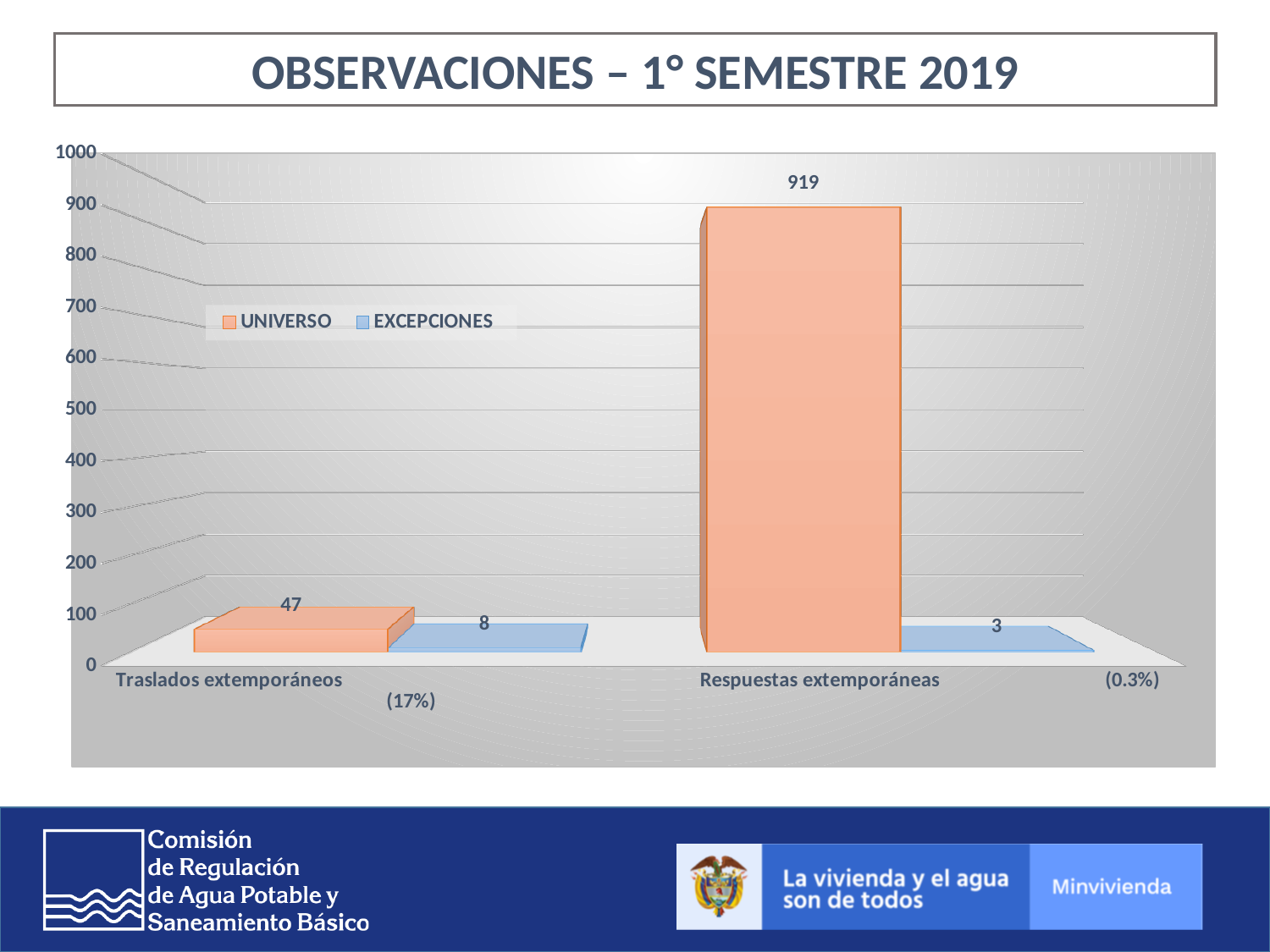
Which is larger: the EXCEPCIONES value for Traslados extemporáneos or for Respuestas extemporáneas? Traslados extemporáneos What kind of chart is shown on the slide? Bar chart What is the difference between the UNIVERSO values for Respuestas extemporáneas and Traslados extemporáneos? 872 What is the EXCEPCIONES value for Respuestas extemporáneas? 3 What is the difference between the UNIVERSO and EXCEPCIONES values for Traslados extemporáneos? 39 Which category has the highest UNIVERSO value? Respuestas extemporáneas What is the UNIVERSO value for Traslados extemporáneos? 47 What is the UNIVERSO value for Respuestas extemporáneas? 919 Which category has the lowest EXCEPCIONES value? Respuestas extemporáneas What is the EXCEPCIONES value for Traslados extemporáneos? 8 What is the title of the slide? OBSERVACIONES – 1° SEMESTRE 2019 How many series does the legend list? 2